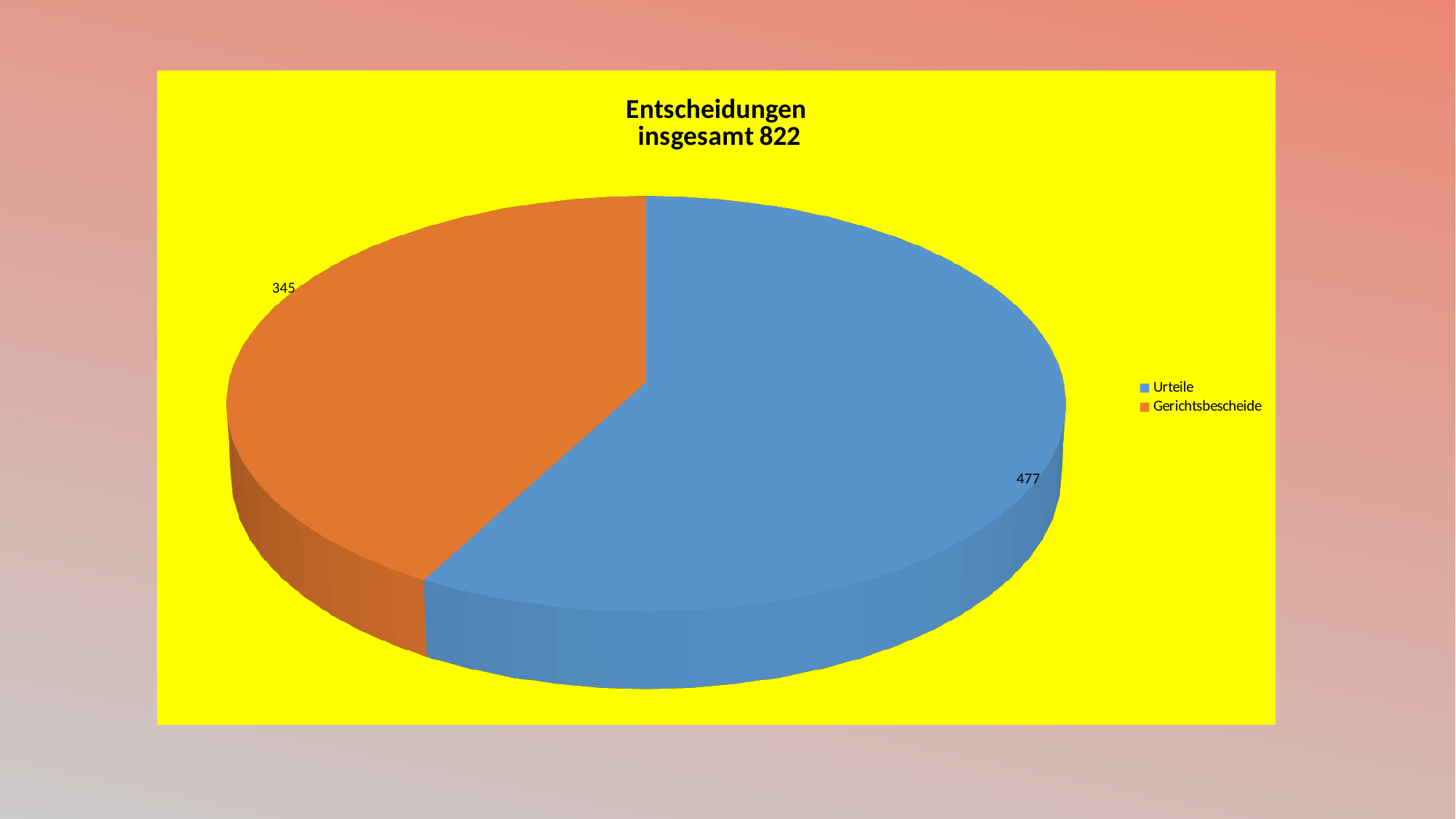
What is the value for Urteile? 477 What is the difference between the values for Urteile and Gerichtsbescheide? 132 What colour is the Gerichtsbescheide slice? Orange Which category has the smallest slice? Gerichtsbescheide Which category has the largest slice? Urteile What is the value for Gerichtsbescheide? 345 Which is larger, Urteile or Gerichtsbescheide? Urteile What is the title of the chart? Entscheidungen insgesamt 822 What kind of chart is shown on the slide? Pie chart How many entries does the legend list? 2 How many slices does the pie chart have? 2 What is the total of all slices in the pie chart? 822